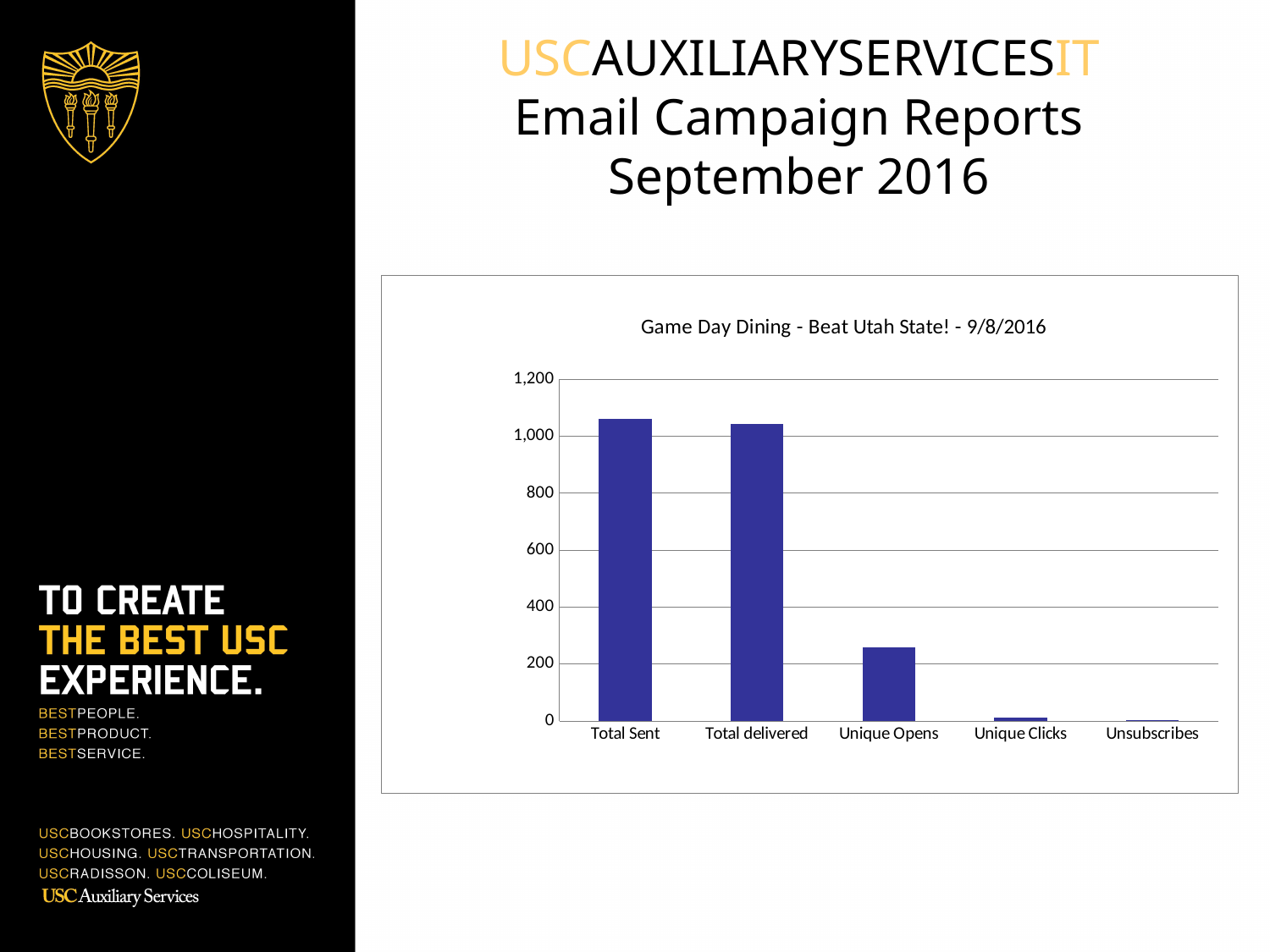
Which is larger, the value for Total delivered or the value for Unique Opens? Total delivered Is the value for Unique Opens greater or less than 200? greater Is the value for Total Sent greater or less than 1,000? greater What is the title of the chart? Game Day Dining - Beat Utah State! - 9/8/2016 Is the value for Total delivered greater or less than 1,000? greater Do the values rise or fall moving from left to right along the x axis? fall How many categories are plotted on the x axis of the chart? 5 What kind of chart is shown on the slide? bar chart Which category has the highest value in the chart? Total Sent Which category has the lowest value in the chart? Unsubscribes